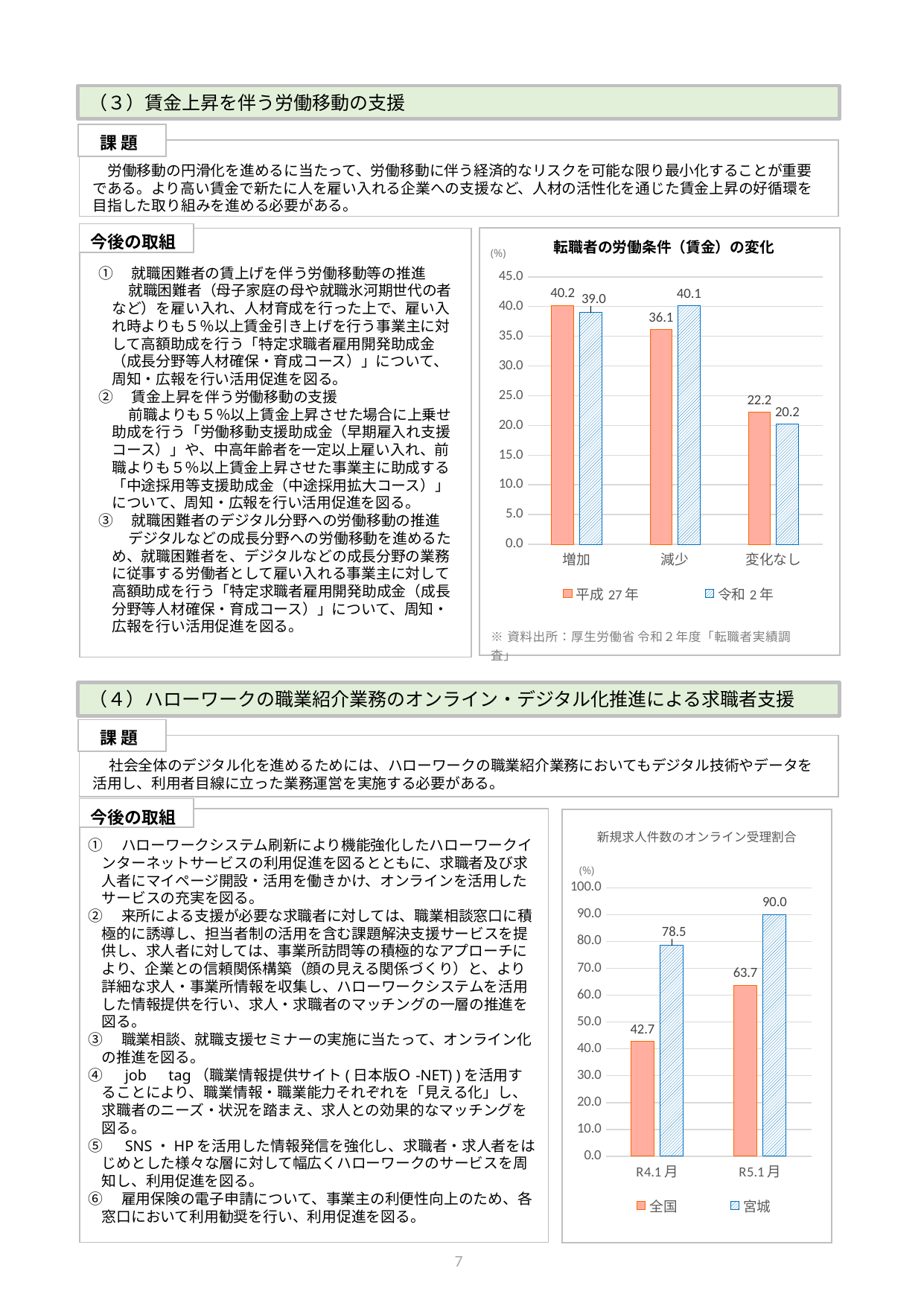
In the chart titled 転職者の労働条件（賃金）の変化, how many categories are shown on the x axis? 3 In the chart titled 転職者の労働条件（賃金）の変化, what is the difference between the 平成27年 and 令和2年 values for 減少? 4.0 In the chart titled 転職者の労働条件（賃金）の変化, what is the value for 減少 in the 令和2年 series? 40.1 In the chart titled 新規求人件数のオンライン受理割合, what is the value for 全国 in R4.1月? 42.7 What kind of chart is the one titled 新規求人件数のオンライン受理割合? bar chart In the chart titled 転職者の労働条件（賃金）の変化, which category has the lowest value in the 令和2年 series? 変化なし In the chart titled 転職者の労働条件（賃金）の変化, what is the value for 増加 in the 平成27年 series? 40.2 In the chart titled 転職者の労働条件（賃金）の変化, how many series does the legend list? 2 In the chart titled 新規求人件数のオンライン受理割合, what is the value for 宮城 in R5.1月? 90.0 In the chart titled 新規求人件数のオンライン受理割合, what is the difference between the 宮城 and 全国 values in R4.1月? 35.8 In the chart titled 新規求人件数のオンライン受理割合, does the 全国 value rise or fall from R4.1月 to R5.1月? rise In the chart titled 転職者の労働条件（賃金）の変化, which is larger for 変化なし: the 平成27年 value or the 令和2年 value? 平成27年